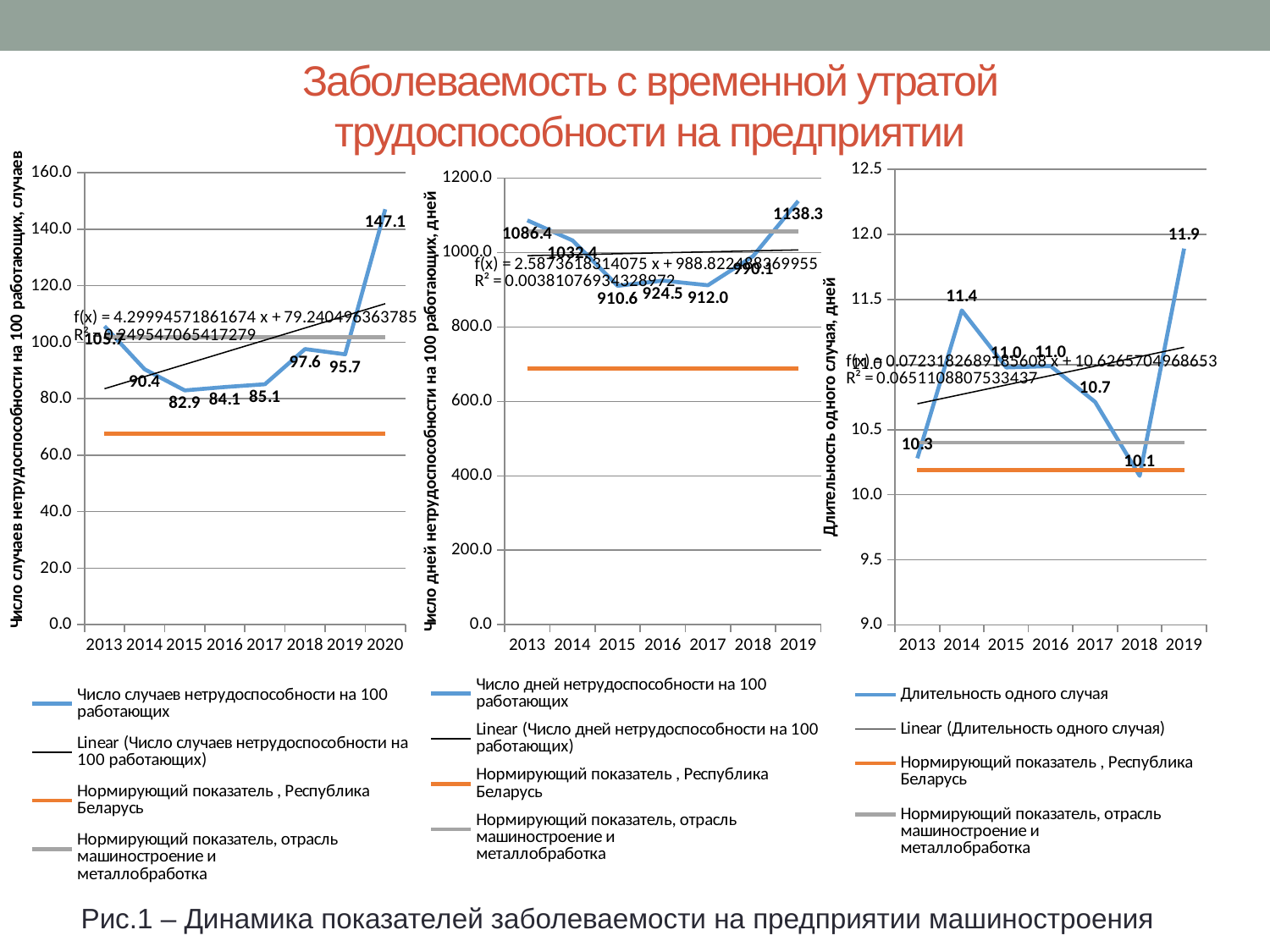
In the left chart, how many years are plotted on the x axis? 8 What type of chart is the left chart? Line chart In the middle chart, is the Нормирующий показатель, Республика Беларусь line greater or less than 600.0? greater In the left chart, what is the difference between the 2020 value and the 2013 value? 41.4 In the right chart (Длительность одного случая), which year has the highest value? 2019 In the middle chart, is the value for 2013 or 2018 larger? 2013 In the left chart, which year has the lowest number of cases per 100 workers? 2015 In the middle chart (Число дней нетрудоспособности на 100 работающих), what is the value for 2019? 1138.3 In the middle chart, which year has the lowest number of days of incapacity per 100 workers? 2015 In the left chart (Число случаев нетрудоспособности на 100 работающих), what is the value for 2020? 147.1 In the right chart, what is the difference between the 2019 value and the 2018 value? 1.8 How many entries does the legend of the right chart list? 4